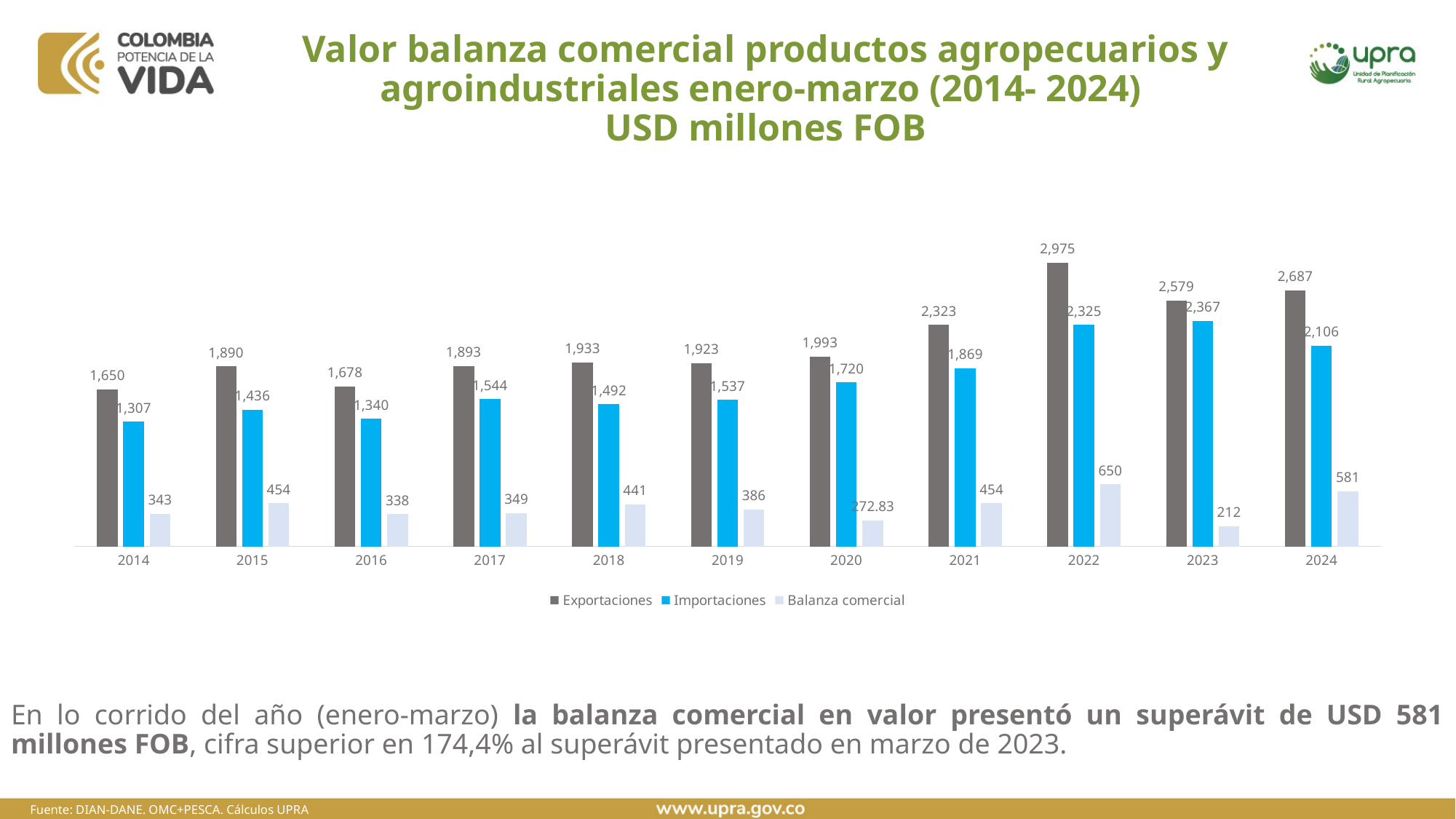
Which year has the highest Exportaciones value? 2022 What is the value of Balanza comercial in 2020? 272.83 Which is larger, Importaciones in 2023 or Importaciones in 2024? Importaciones in 2023 Which series is shown in blue? Importaciones What kind of chart is shown on the slide? Bar chart What is the value of Importaciones in 2014? 1,307 Which year has the lowest Balanza comercial value? 2023 How many series does the legend list? 3 Did Balanza comercial rise or fall from 2022 to 2023? Fall How many years are shown on the x axis? 11 What is the difference between Exportaciones and Importaciones in 2024? 581 What is the value of Exportaciones in 2022? 2,975